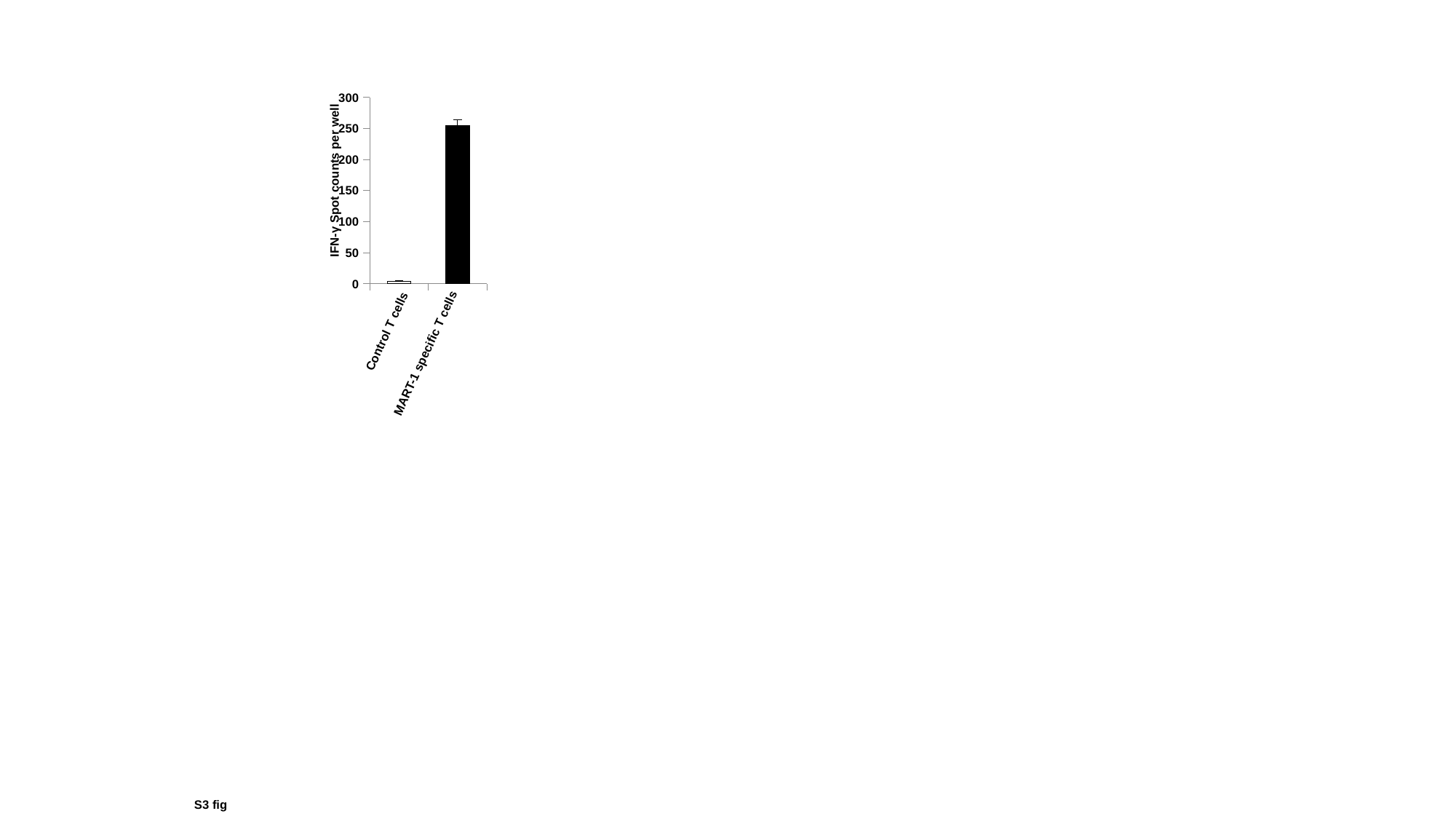
Which category has the lowest IFN-γ spot count per well? Control T cells What is the maximum value shown on the y axis? 300 What kind of chart is shown on the slide? bar chart Which has a larger value, Control T cells or MART-1 specific T cells? MART-1 specific T cells Which category has the highest IFN-γ spot count per well? MART-1 specific T cells Is the value for MART-1 specific T cells greater or less than 200? greater How many categories are plotted on the x axis? 2 What is the label of the y axis? IFN-γ Spot counts per well Is the value for Control T cells greater or less than 50? less Is the value for MART-1 specific T cells greater or less than 300? less